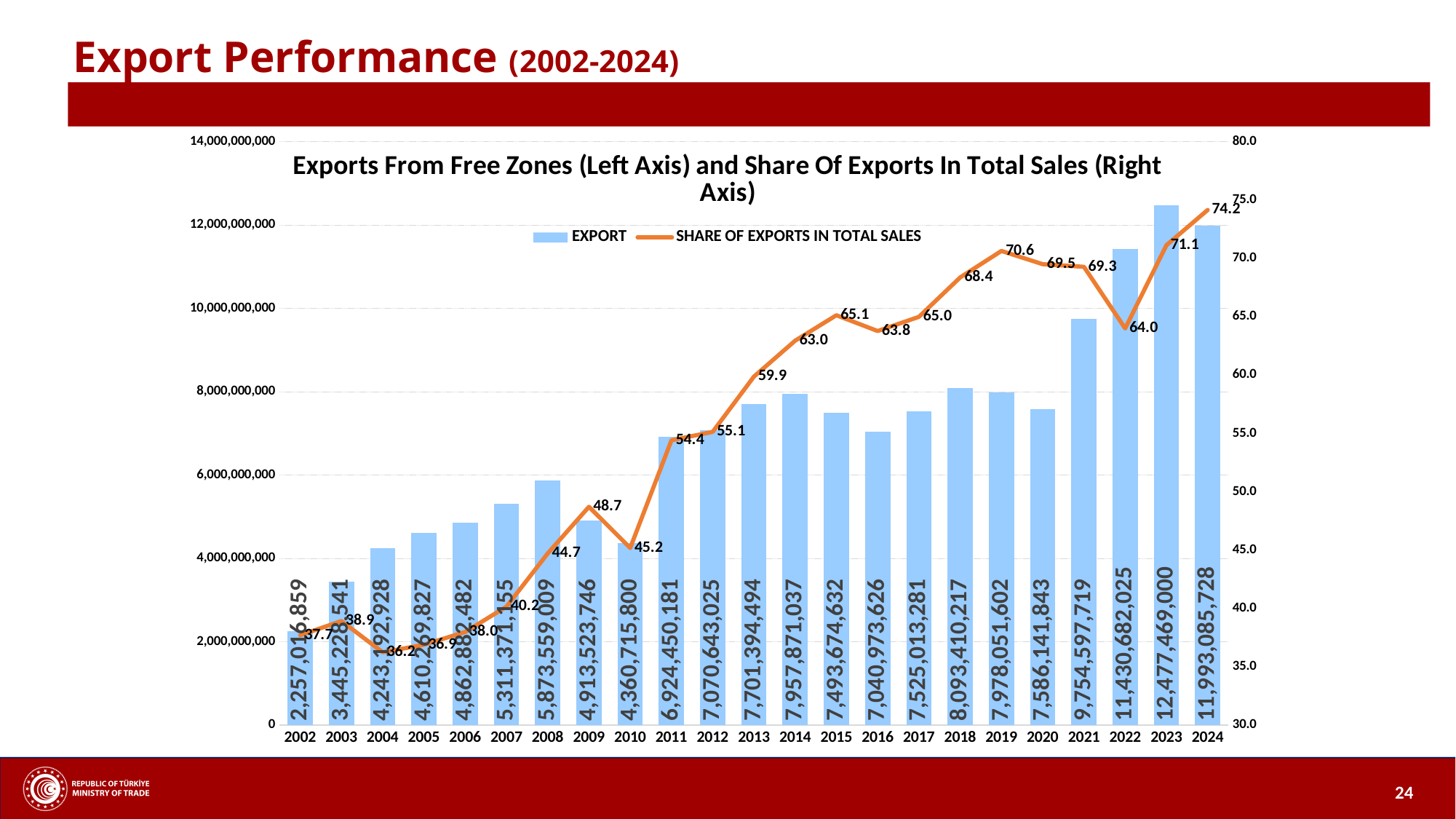
What was the export value from free zones in 2023? 12,477,469,000 What was the export value from free zones in 2010? 4,360,715,800 How many series does the chart legend list? 2 What was the share of exports in total sales in 2022? 64.0 Which year had a higher export value from free zones, 2018 or 2019? 2018 Is the export value from free zones in 2021 greater or less than 10,000,000,000? less How many years are shown on the x axis of the chart? 23 What was the share of exports in total sales in 2024? 74.2 Which year had the lowest share of exports in total sales? 2004 Which year had the highest export value from free zones? 2023 What is the difference between the share of exports in total sales in 2024 and in 2022? 10.2 What kind of chart is used to show the EXPORT series? bar chart